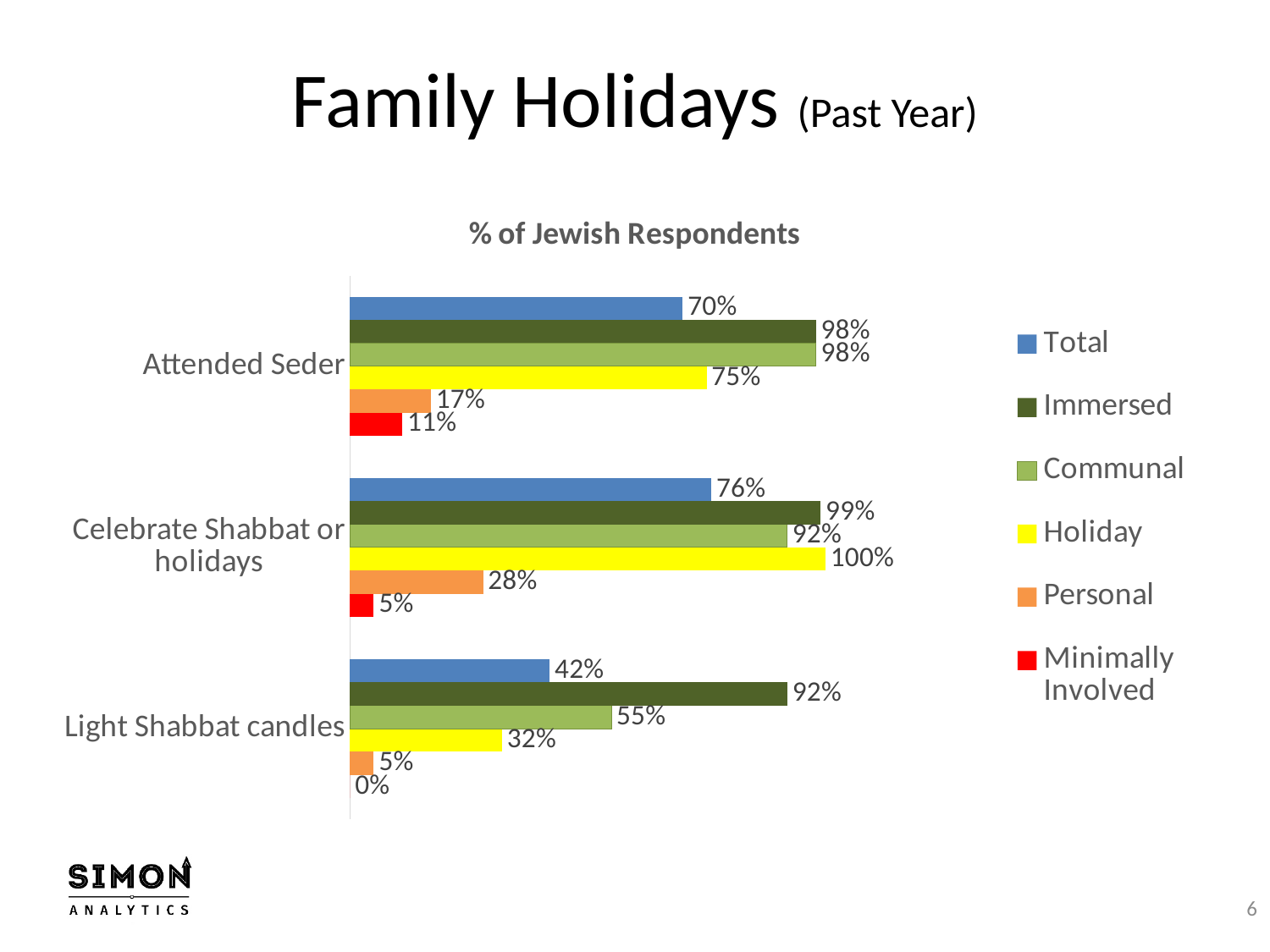
What is the Minimally Involved value for Light Shabbat candles? 0% Which category has the highest Total value? Celebrate Shabbat or holidays How many series does the legend list? 6 Which is larger for Attended Seder: the Holiday value or the Personal value? Holiday What is the Holiday value for Celebrate Shabbat or holidays? 100% What is the difference between the Immersed and Total values for Light Shabbat candles? 50% Which category has the lowest Personal value? Light Shabbat candles What is the Immersed value for Light Shabbat candles? 92% How many categories are shown on the chart? 3 What is the title of the chart? % of Jewish Respondents What kind of chart is shown on the slide? Bar chart What is the Total value for Attended Seder? 70%